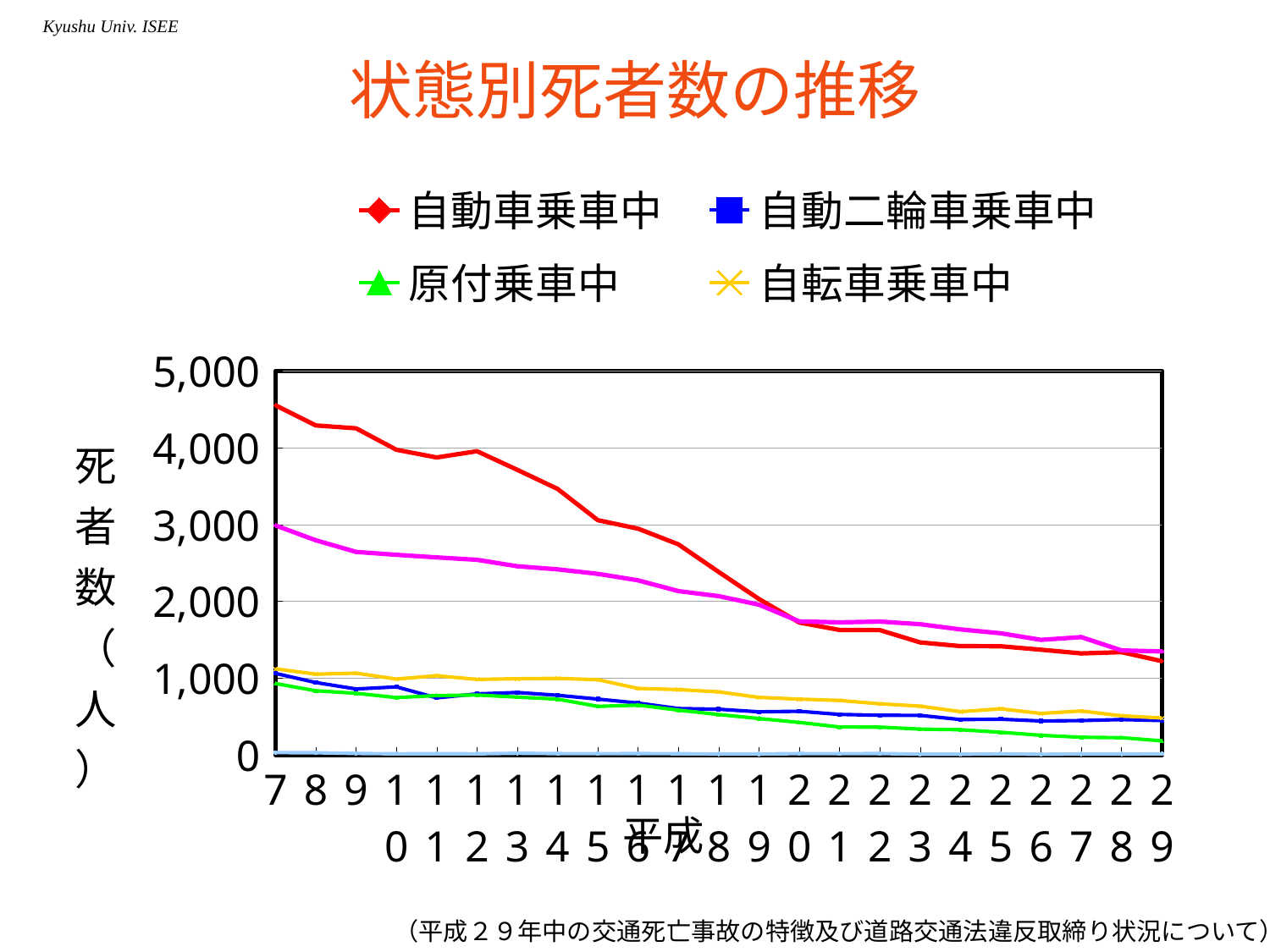
What kind of chart is shown on the slide? line chart How many years (points) are shown along the x axis? 23 Is the value for 自動車乗車中 in 平成7 greater or less than 4,000? greater What is the title of the chart? 状態別死者数の推移 Is the value for 自動二輪車乗車中 in 平成29 greater or less than 1,000? less Which legend series has the highest value in 平成7? 自動車乗車中 In 平成29, which is larger: 自転車乗車中 or 原付乗車中? 自転車乗車中 What colour is the line for 自動車乗車中? red Is the value for 自動車乗車中 in 平成29 greater or less than 2,000? less How many series does the legend list? 4 Does the 自動車乗車中 series rise or fall from 平成7 to 平成29? fall Which of the four legend series has the lowest value in 平成29? 原付乗車中